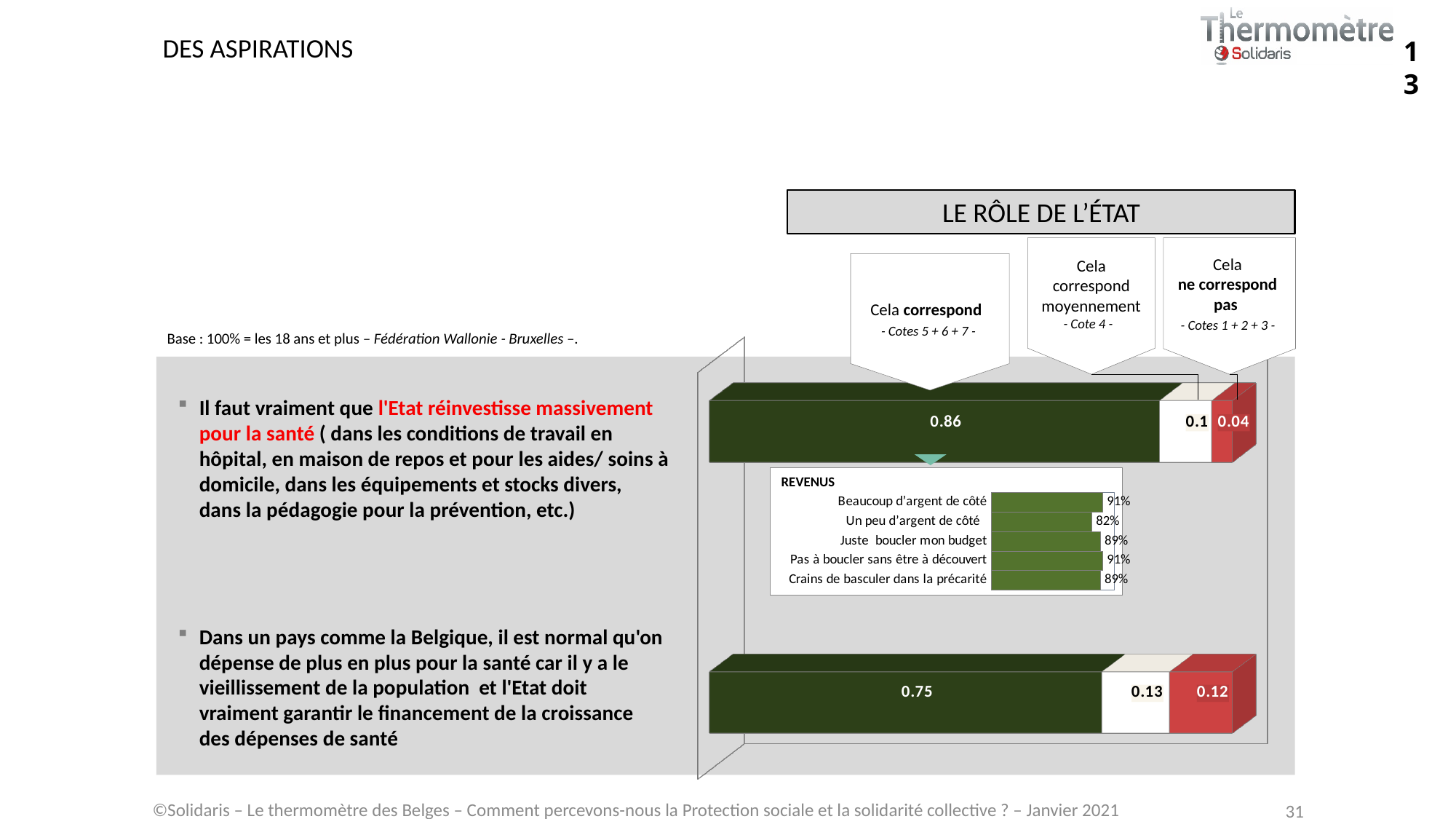
In the bottom stacked bar (about Belgium spending more on health), what is the value for 'Cela correspond moyennement'? 0.13 In the top stacked bar (about the State reinvesting massively in health), what is the value for 'Cela correspond'? 0.86 What type of chart is the REVENUS inset chart? Bar chart What is the difference between the 'Cela correspond' values of the top stacked bar and the bottom stacked bar? 0.11 In the top stacked bar (about the State reinvesting massively in health), what is the value for 'Cela ne correspond pas'? 0.04 Which stacked bar has the larger 'Cela ne correspond pas' value, the top one or the bottom one? The bottom one In the REVENUS inset chart, what is the difference between 'Beaucoup d'argent de côté' and 'Un peu d'argent de côté'? 9 percentage points In the REVENUS inset chart, what is the value for 'Juste boucler mon budget'? 89% In the REVENUS inset chart, which category has the lowest value? Un peu d'argent de côté In the REVENUS inset chart, what is the value for 'Un peu d'argent de côté'? 82% How many categories are shown in the REVENUS inset chart? 5 In the bottom stacked bar (about Belgium spending more on health), what is the value for 'Cela ne correspond pas'? 0.12